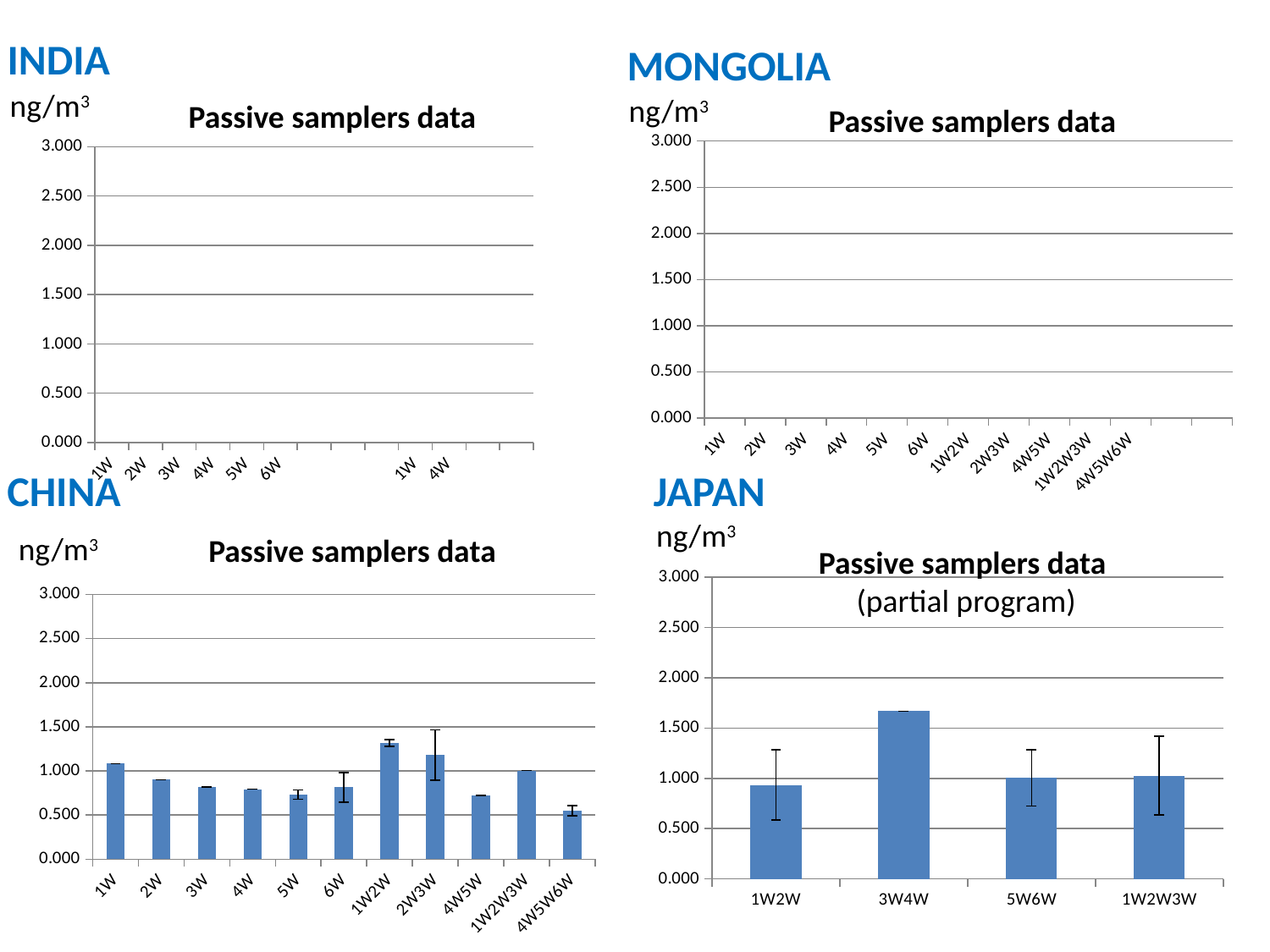
On the CHINA chart, is the value for 1W2W greater or less than 1.000? greater On the JAPAN chart, which is larger, the value for 3W4W or the value for 1W2W? 3W4W On the CHINA chart, is the value for 4W5W6W greater or less than 1.000? less On the JAPAN chart, is the value for 3W4W greater or less than 1.500? greater What kind of chart is the CHINA chart? bar chart On the JAPAN chart, which category has the highest value? 3W4W On the CHINA chart, which is larger, the value for 1W2W or the value for 4W5W? 1W2W How many categories are shown on the x axis of the JAPAN chart? 4 On the CHINA chart, which category has the lowest value? 4W5W6W How many categories are shown on the x axis of the CHINA chart? 11 On the CHINA chart, which category has the highest value? 1W2W